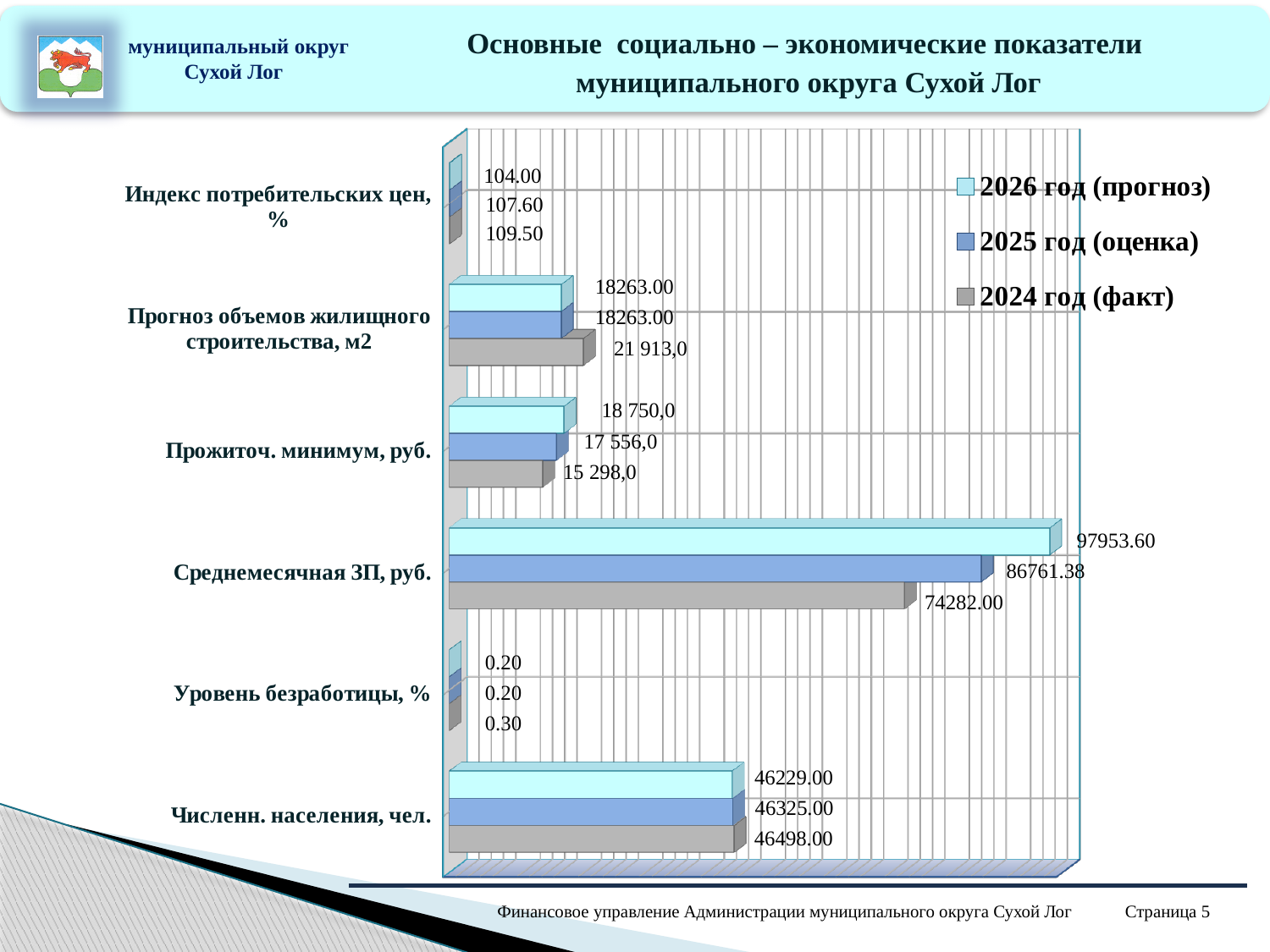
What is the value for Численн. населения, чел. in the 2024 год (факт) series? 46498.00 Which is larger for Численн. населения, чел.: the 2025 год (оценка) value or the 2026 год (прогноз) value? 2025 год (оценка) Which series has the highest value for Прогноз объемов жилищного строительства, м2? 2024 год (факт) What is the value for Индекс потребительских цен, % in the 2025 год (оценка) series? 107.60 Which series has the lowest value for Среднемесячная ЗП, руб.? 2024 год (факт) How many categories are shown on the chart? 6 What is the difference between the 2026 год (прогноз) and 2024 год (факт) values for Среднемесячная ЗП, руб.? 23671.60 How many series does the legend list? 3 What is the value for Прожиточ. минимум, руб. in the 2024 год (факт) series? 15 298,0 Which legend entry is shown in grey? 2024 год (факт) What kind of chart is shown on the slide? Bar chart What is the value for Среднемесячная ЗП, руб. in the 2026 год (прогноз) series? 97953.60